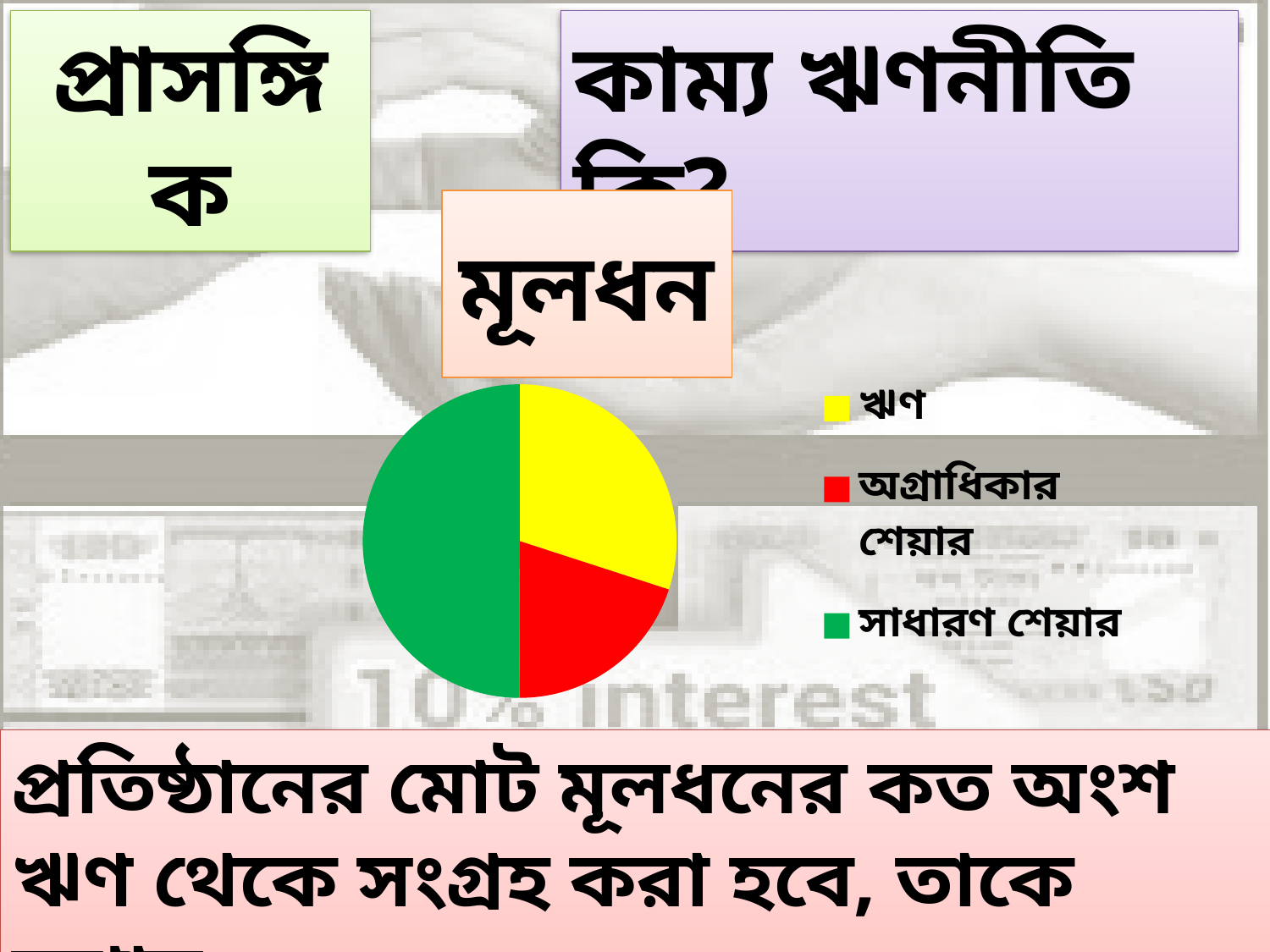
What kind of chart is shown on the slide? pie chart How many entries does the legend of the pie chart list? 3 Which category has the smallest slice in the pie chart? অগ্রাধিকার শেয়ার How many slices does the pie chart have? 3 Which slice is larger in the pie chart, ঋণ or অগ্রাধিকার শেয়ার? ঋণ Which category has the largest slice in the pie chart? সাধারণ শেয়ার What is the title shown above the pie chart? মূলধন What colour represents ঋণ in the pie chart? yellow Which slice is larger in the pie chart, সাধারণ শেয়ার or ঋণ? সাধারণ শেয়ার